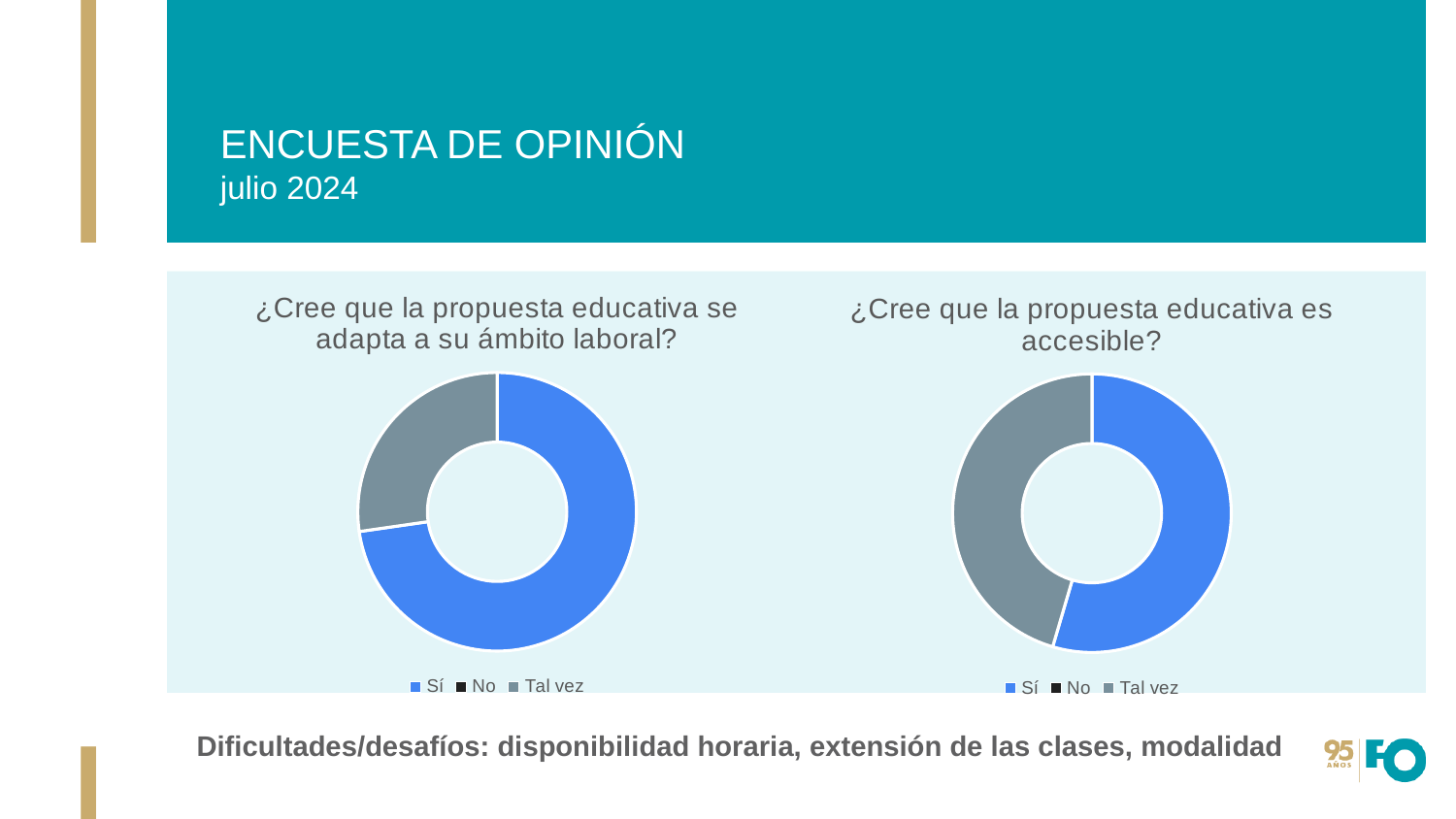
In the chart "¿Cree que la propuesta educativa se adapta a su ámbito laboral?", which is larger, the slice for Sí or the slice for Tal vez? Sí Which chart shows a larger share for Sí, the left chart ("se adapta a su ámbito laboral") or the right chart ("es accesible")? The left chart What are the legend entries of the chart "¿Cree que la propuesta educativa es accesible?"? Sí, No, Tal vez What kind of chart is used for "¿Cree que la propuesta educativa es accesible?"? Doughnut chart In the chart "¿Cree que la propuesta educativa es accesible?", which response has the largest slice? Sí In the chart "¿Cree que la propuesta educativa se adapta a su ámbito laboral?", how many entries does the legend list? 3 In the chart "¿Cree que la propuesta educativa es accesible?", which is larger, the slice for Sí or the slice for Tal vez? Sí In the chart "¿Cree que la propuesta educativa se adapta a su ámbito laboral?", what colour represents Sí? Blue What kind of chart is used for "¿Cree que la propuesta educativa se adapta a su ámbito laboral?"? Doughnut chart In the chart "¿Cree que la propuesta educativa se adapta a su ámbito laboral?", which response has the largest slice? Sí In the chart "¿Cree que la propuesta educativa es accesible?", how many entries does the legend list? 3